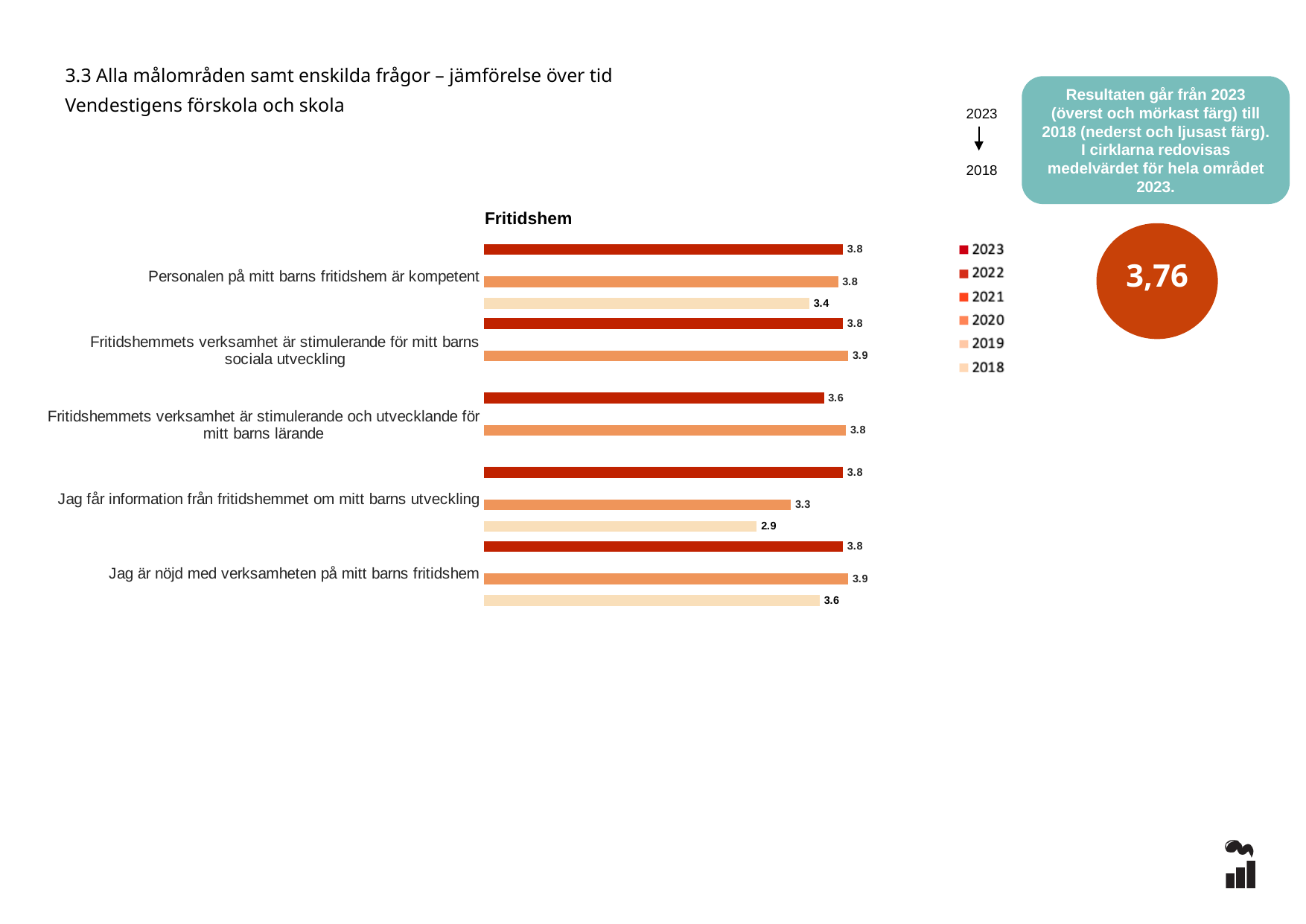
What is the difference between the top bar (3.8) and the lightest bar (2.9) for "Jag får information från fritidshemmet om mitt barns utveckling"? 0.9 What is the value of the lightest (bottom) bar for "Jag får information från fritidshemmet om mitt barns utveckling"? 2.9 How many series does the legend of the Fritidshem chart list? 6 What is the value of the top (darkest) bar for "Fritidshemmets verksamhet är stimulerande och utvecklande för mitt barns lärande"? 3.6 What is the value of the top (darkest) bar for "Personalen på mitt barns fritidshem är kompetent"? 3.8 Which bar in the Fritidshem chart has the lowest value? The lightest bar for "Jag får information från fritidshemmet om mitt barns utveckling" (2.9) What is the value of the lightest (bottom) bar for "Personalen på mitt barns fritidshem är kompetent"? 3.4 How many categories (questions) are plotted in the Fritidshem chart? 5 What is the value of the middle (orange) bar for "Jag är nöjd med verksamheten på mitt barns fritidshem"? 3.9 For "Fritidshemmets verksamhet är stimulerande och utvecklande för mitt barns lärande", which is larger: the top (darkest) bar or the middle (orange) bar? the middle (orange) bar What mean value for the whole area in 2023 is shown in the orange circle? 3,76 What kind of chart is shown under the heading "Fritidshem"? bar chart